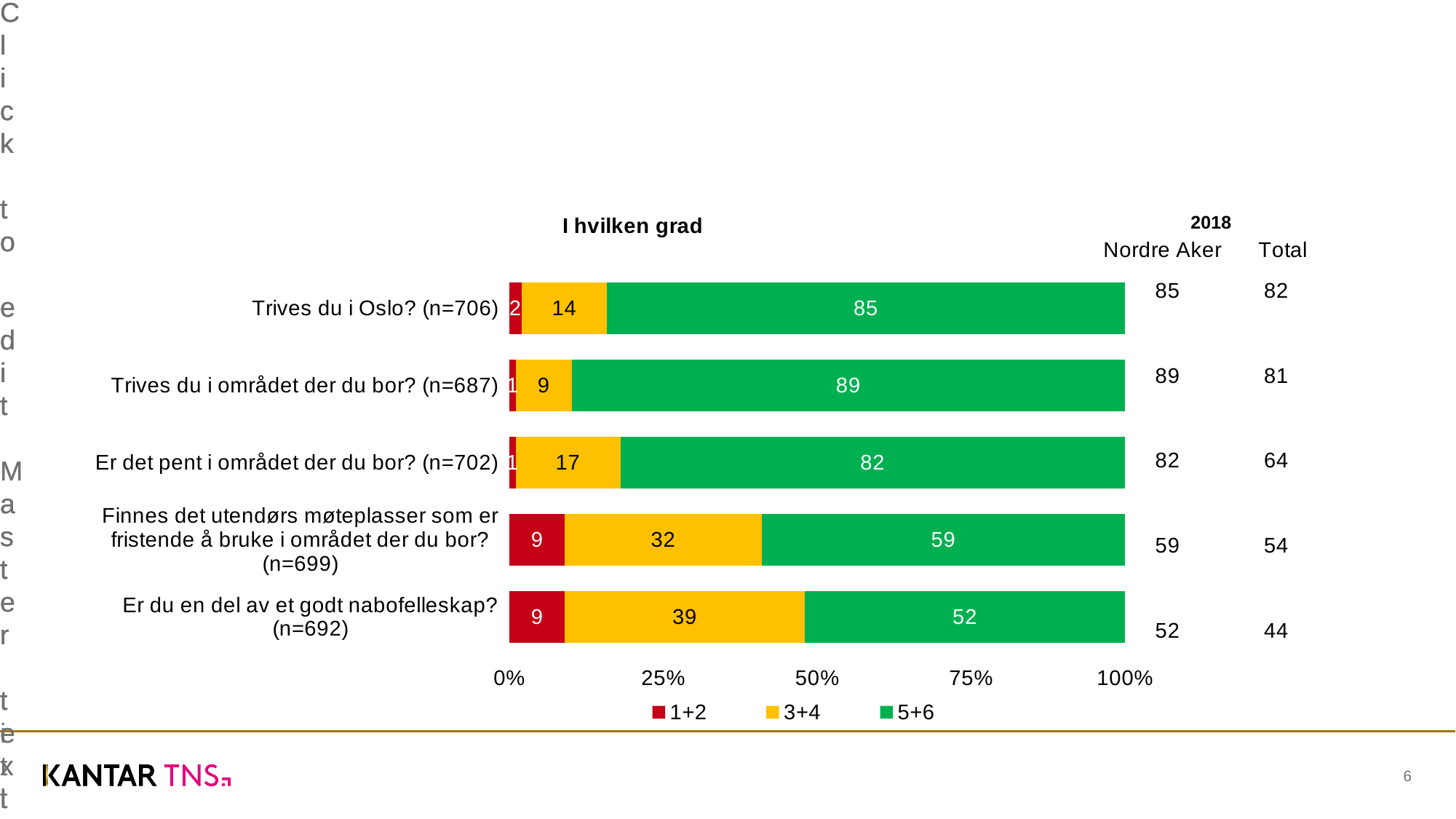
Which is larger: the 5+6 value for "Er det pent i området der du bor? (n=702)" or for "Finnes det utendørs møteplasser som er fristende å bruke i området der du bor? (n=699)"? Er det pent i området der du bor? (n=702) How many series does the legend list? 3 What is the 3+4 value for "Er du en del av et godt nabofelleskap? (n=692)"? 39 Which category has the lowest 5+6 value? Er du en del av et godt nabofelleskap? (n=692) Which category has the highest 5+6 value? Trives du i området der du bor? (n=687) What is the title of the chart? I hvilken grad What is the Total value shown for "Er det pent i området der du bor? (n=702)" in the 2018 column? 64 How many questions (categories) are plotted in the chart? 5 What is the 1+2 value for "Finnes det utendørs møteplasser som er fristende å bruke i området der du bor? (n=699)"? 9 What kind of chart is shown on the slide? Stacked bar chart What is the 5+6 value for "Trives du i området der du bor? (n=687)"? 89 What is the difference between the 3+4 values for "Er du en del av et godt nabofelleskap? (n=692)" and "Trives du i Oslo? (n=706)"? 25